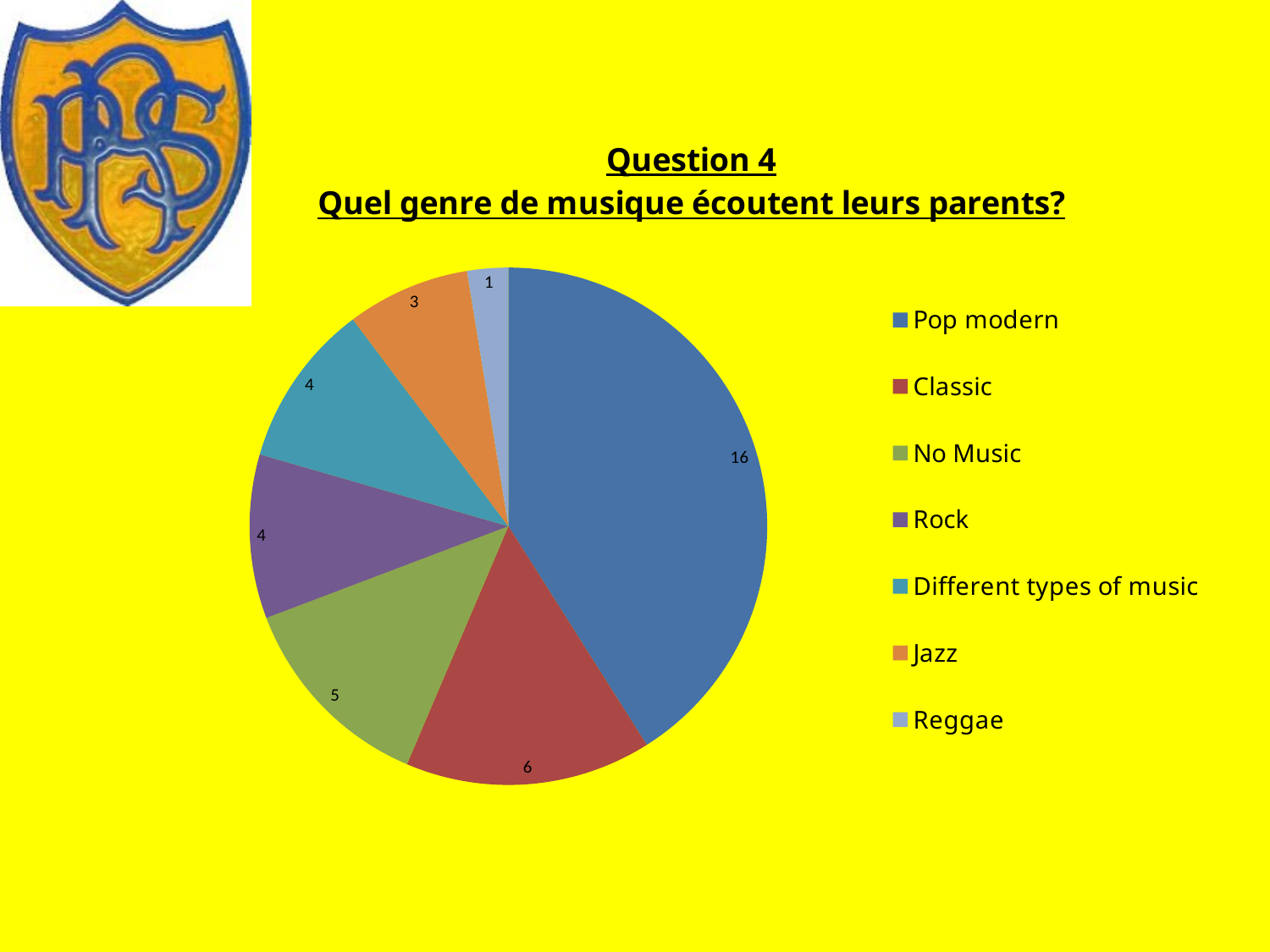
What is the value for Pop modern? 16 What is the total of all the values in the pie chart? 39 What is the value for Classic? 6 Which category has the largest slice? Pop modern What is the difference between the values for Pop modern and Classic? 10 What is the value for Jazz? 3 What type of chart is shown on the slide? pie chart What is the value for Reggae? 1 What is the value for No Music? 5 How many categories does the legend list? 7 Which category has the smallest slice? Reggae Which is larger, the value for No Music or the value for Jazz? No Music